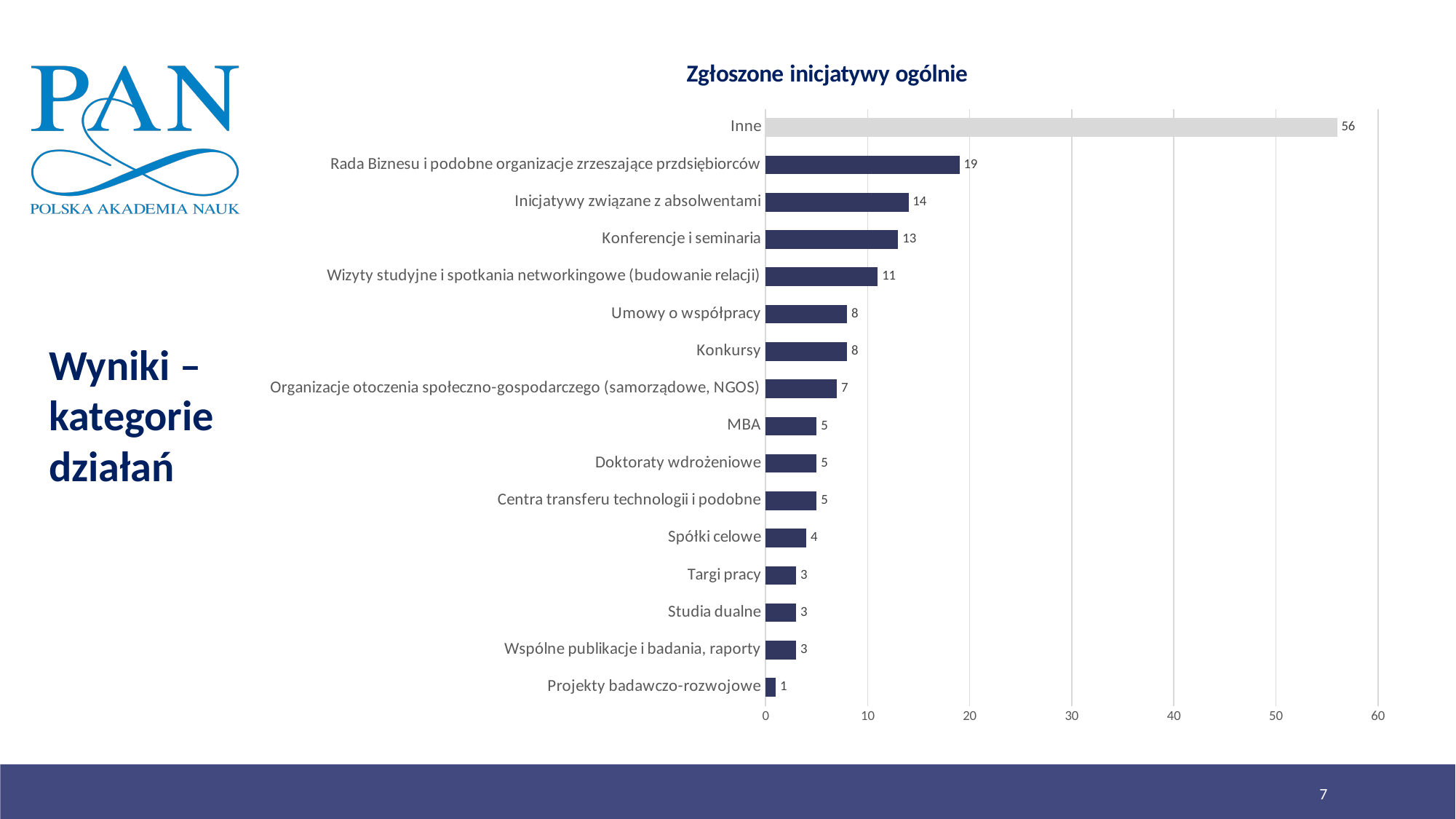
Which category has the highest value? Inne What is the value for "Konferencje i seminaria"? 13 How many categories are shown in the chart? 16 Which is larger, the value for "Wizyty studyjne i spotkania networkingowe (budowanie relacji)" or the value for "Umowy o współpracy"? Wizyty studyjne i spotkania networkingowe (budowanie relacji) Is the value for "Inne" greater or less than 50? greater Which bar is coloured differently (grey) from the others? Inne What is the difference between the values for "Rada Biznesu i podobne organizacje zrzeszające przdsiębiorców" and "Inicjatywy związane z absolwentami"? 5 Which category has the lowest value? Projekty badawczo-rozwojowe What is the title of the chart? Zgłoszone inicjatywy ogólnie What kind of chart is shown on the slide? bar chart What is the value for "Spółki celowe"? 4 What is the value for "Inne"? 56